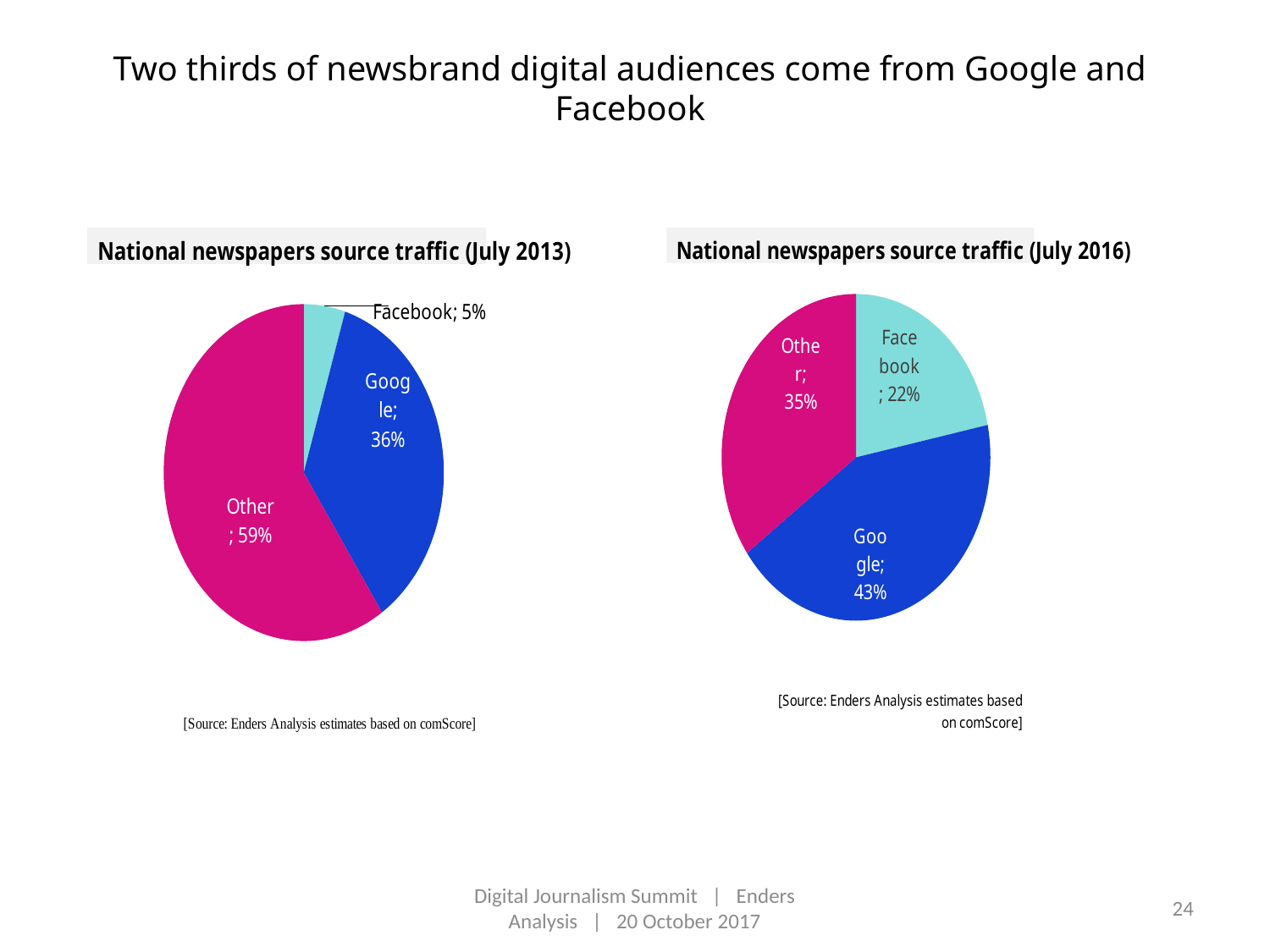
In the 'National newspapers source traffic (July 2016)' chart, what share of traffic comes from Facebook? 22% How many slices does the 'National newspapers source traffic (July 2016)' chart have? 3 In the 'National newspapers source traffic (July 2016)' chart, what share of traffic comes from Google? 43% In the 'National newspapers source traffic (July 2013)' chart, what share of traffic comes from Google? 36% In the 'National newspapers source traffic (July 2016)' chart, what colour is the Google slice? Blue In the 'National newspapers source traffic (July 2013)' chart, what share of traffic comes from Facebook? 5% In the 'National newspapers source traffic (July 2013)' chart, what is the difference between the Other share and the Google share? 23 percentage points In the 'National newspapers source traffic (July 2013)' chart, which source has the largest share? Other In the 'National newspapers source traffic (July 2016)' chart, which source has the smallest share? Facebook What type of chart is the 'National newspapers source traffic (July 2013)' chart? Pie chart In the 'National newspapers source traffic (July 2016)' chart, what share of traffic is labelled Other? 35% In the 'National newspapers source traffic (July 2016)' chart, which is larger, the Google share or the Other share? Google